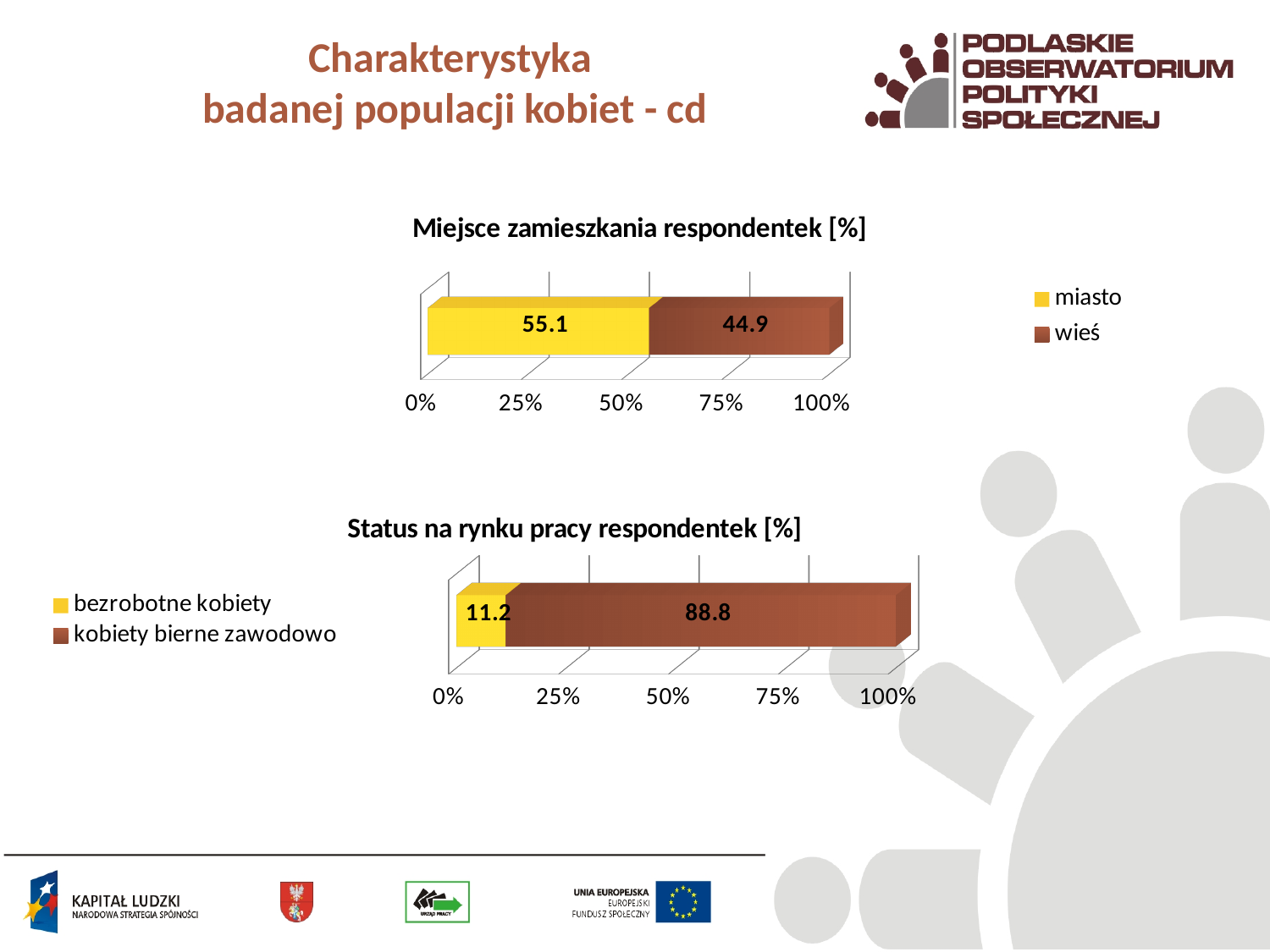
In the chart 'Status na rynku pracy respondentek [%]', which series has the larger value? kobiety bierne zawodowo In the chart 'Status na rynku pracy respondentek [%]', what is the difference between the kobiety bierne zawodowo and bezrobotne kobiety values? 77.6 In the chart 'Miejsce zamieszkania respondentek [%]', what is the value for wieś? 44.9 In the chart 'Miejsce zamieszkania respondentek [%]', what is the value for miasto? 55.1 In the chart 'Status na rynku pracy respondentek [%]', what is the value for bezrobotne kobiety? 11.2 In the chart 'Miejsce zamieszkania respondentek [%]', which series has the larger value, miasto or wieś? miasto In the chart 'Status na rynku pracy respondentek [%]', what is the total of the stacked bar? 100 What kind of chart is 'Status na rynku pracy respondentek [%]'? stacked bar chart In the chart 'Miejsce zamieszkania respondentek [%]', what colour represents wieś? brown In the chart 'Miejsce zamieszkania respondentek [%]', what is the difference between the miasto and wieś values? 10.2 In the chart 'Status na rynku pracy respondentek [%]', what is the value for kobiety bierne zawodowo? 88.8 In the chart 'Miejsce zamieszkania respondentek [%]', how many series does the legend list? 2